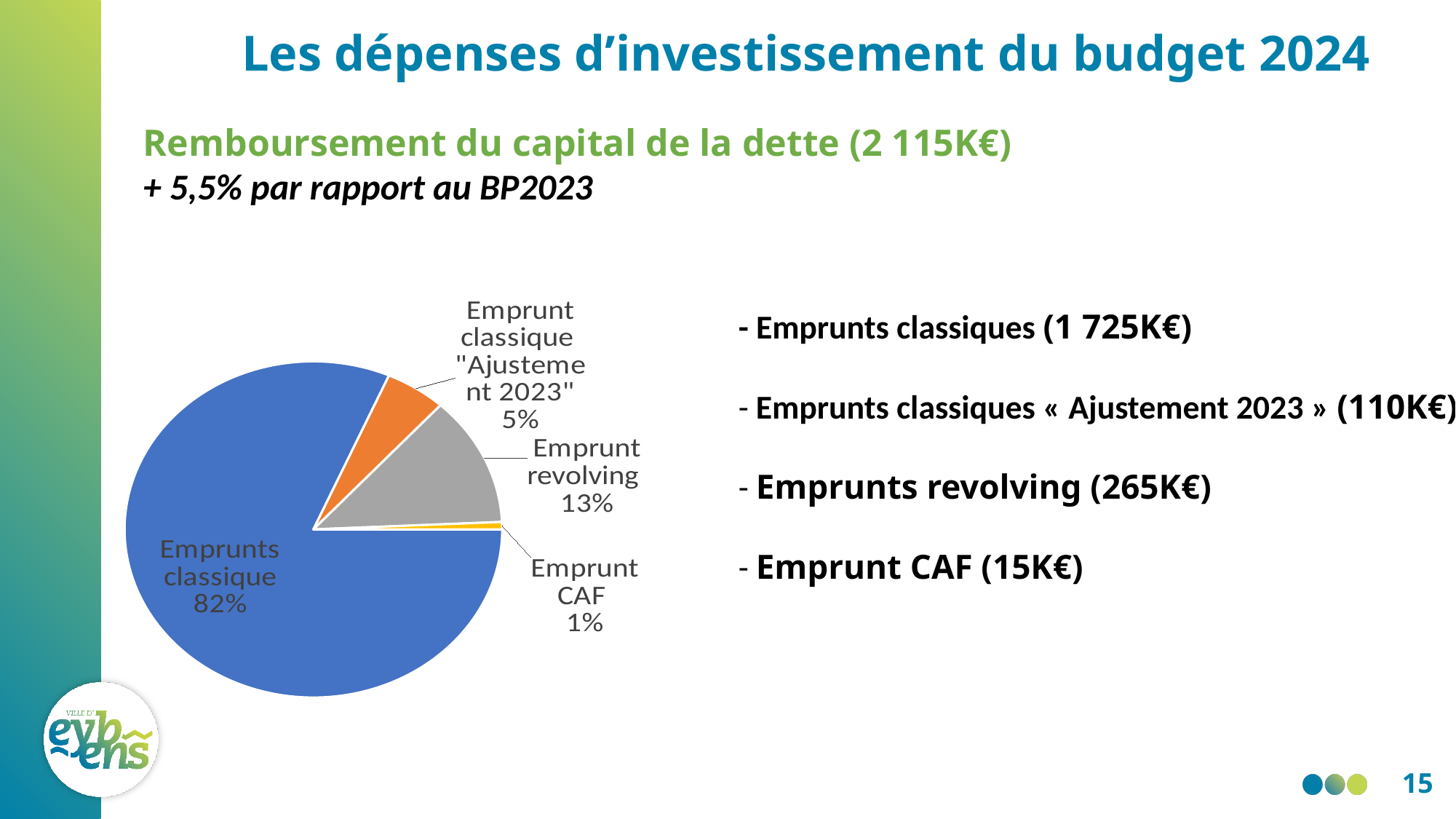
What share of the pie does "Emprunt classique "Ajustement 2023"" represent? 5% What share of the pie does "Emprunts classique" represent? 82% What colour is the "Emprunt revolving" slice of the pie? grey Which slice of the pie is the largest? Emprunts classique Which is larger: the share for "Emprunt revolving" or the share for "Emprunt classique "Ajustement 2023""? Emprunt revolving How many slices does the pie chart have? 4 What share of the pie does "Emprunt revolving" represent? 13% Which slice of the pie is the smallest? Emprunt CAF What kind of chart is shown on the slide? pie chart What is the difference in percentage points between the "Emprunt revolving" share and the "Emprunt CAF" share? 12 What is the difference in percentage points between the "Emprunts classique" share and the "Emprunt revolving" share? 69